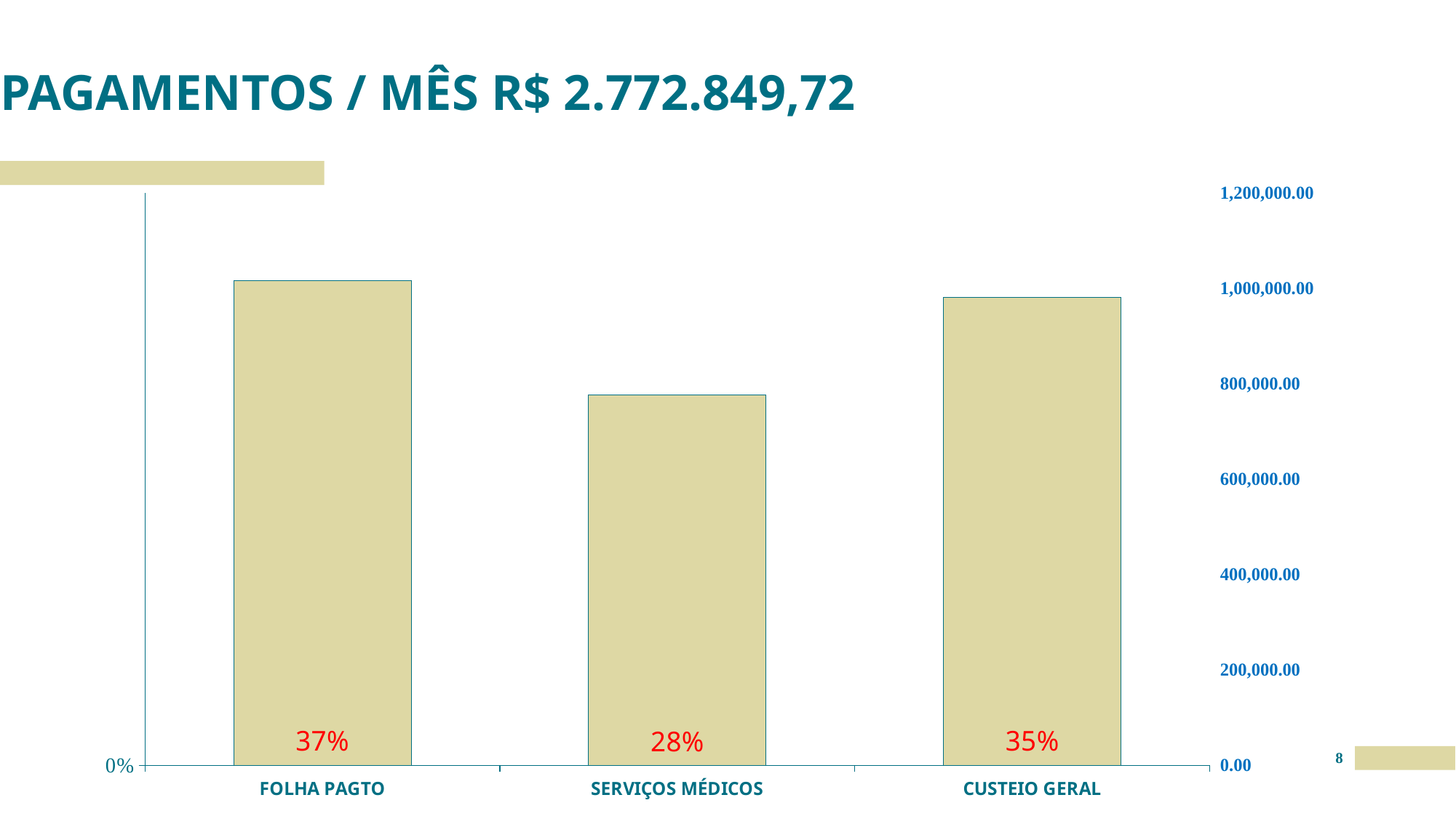
What percentage label is shown on the FOLHA PAGTO bar? 37% Which category has the highest bar? FOLHA PAGTO Which is larger, the bar for FOLHA PAGTO or the bar for CUSTEIO GERAL? FOLHA PAGTO What kind of chart is shown on the slide? bar chart What is the title of the slide above the chart? PAGAMENTOS / MÊS R$ 2.772.849,72 How many categories are shown on the x axis? 3 Is the value for CUSTEIO GERAL greater or less than 800,000.00 on the right-hand axis? greater What is the difference in percentage points between the FOLHA PAGTO label and the SERVIÇOS MÉDICOS label? 9% What percentage label is shown on the SERVIÇOS MÉDICOS bar? 28% What percentage label is shown on the CUSTEIO GERAL bar? 35% Is the value for SERVIÇOS MÉDICOS greater or less than 600,000.00 on the right-hand axis? greater Which category has the lowest bar? SERVIÇOS MÉDICOS